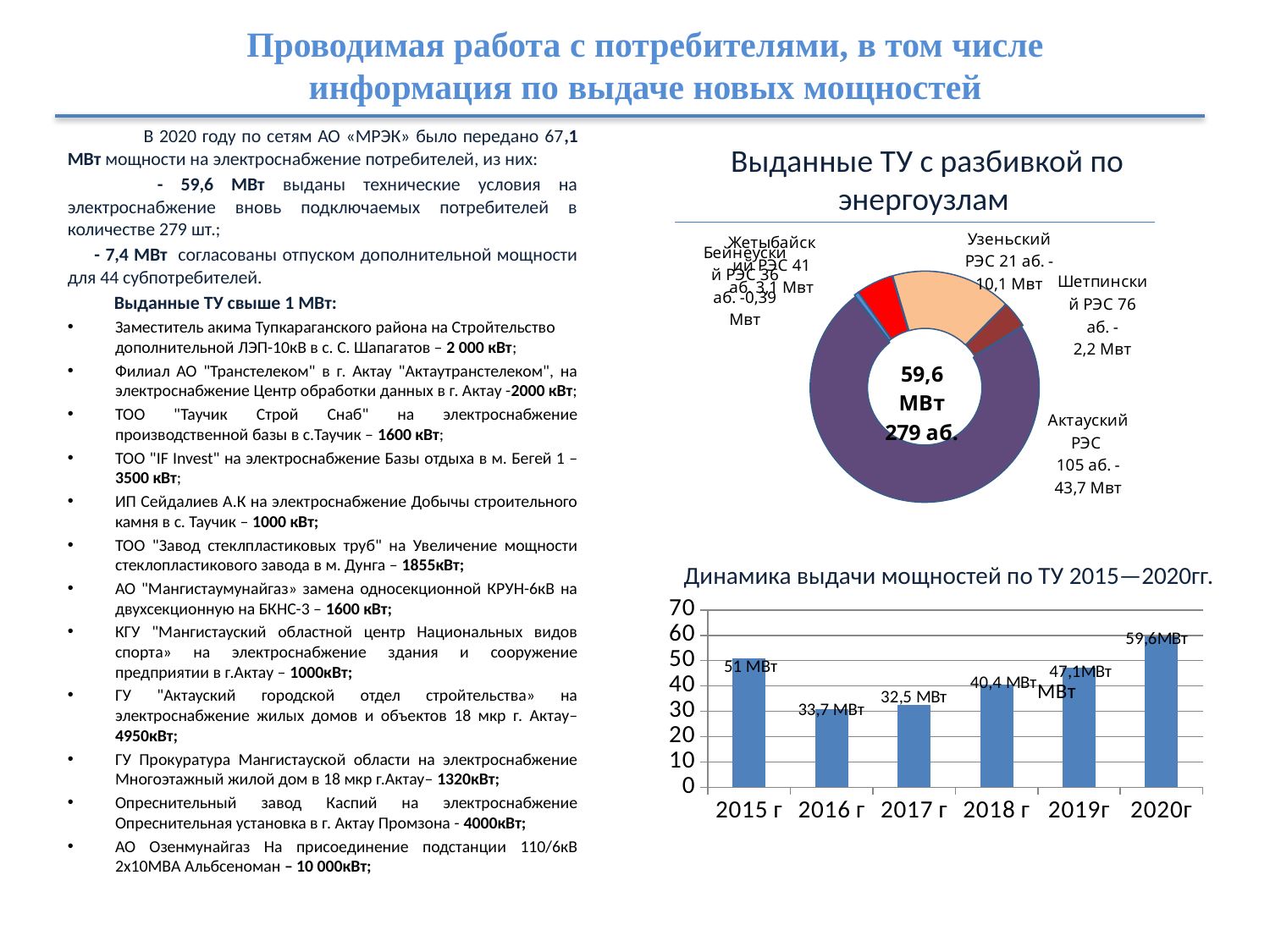
In the doughnut chart 'Выданные ТУ с разбивкой по энергоузлам', how many МВт were issued for Актауский РЭС? 43,7 Мвт In the doughnut chart 'Выданные ТУ с разбивкой по энергоузлам', what total is shown in the centre of the chart? 59,6 МВт 279 аб. In the bar chart 'Динамика выдачи мощностей по ТУ 2015—2020гг.', how many years are shown on the x axis? 6 In the bar chart 'Динамика выдачи мощностей по ТУ 2015—2020гг.', what is the value for 2017 г? 32,5 МВт What kind of chart is 'Динамика выдачи мощностей по ТУ 2015—2020гг.'? bar chart In the bar chart 'Динамика выдачи мощностей по ТУ 2015—2020гг.', which year has the highest value? 2020г In the bar chart 'Динамика выдачи мощностей по ТУ 2015—2020гг.', which is larger, the value for 2018 г or 2019г? 2019г In the doughnut chart 'Выданные ТУ с разбивкой по энергоузлам', which energy node has the largest share? Актауский РЭС In the bar chart 'Динамика выдачи мощностей по ТУ 2015—2020гг.', do the values rise or fall from 2017 г to 2020г? rise In the bar chart 'Динамика выдачи мощностей по ТУ 2015—2020гг.', what is the value for 2020г? 59,6МВт In the bar chart 'Динамика выдачи мощностей по ТУ 2015—2020гг.', what is the difference between the 2020г and 2015 г values? 8,6 МВт